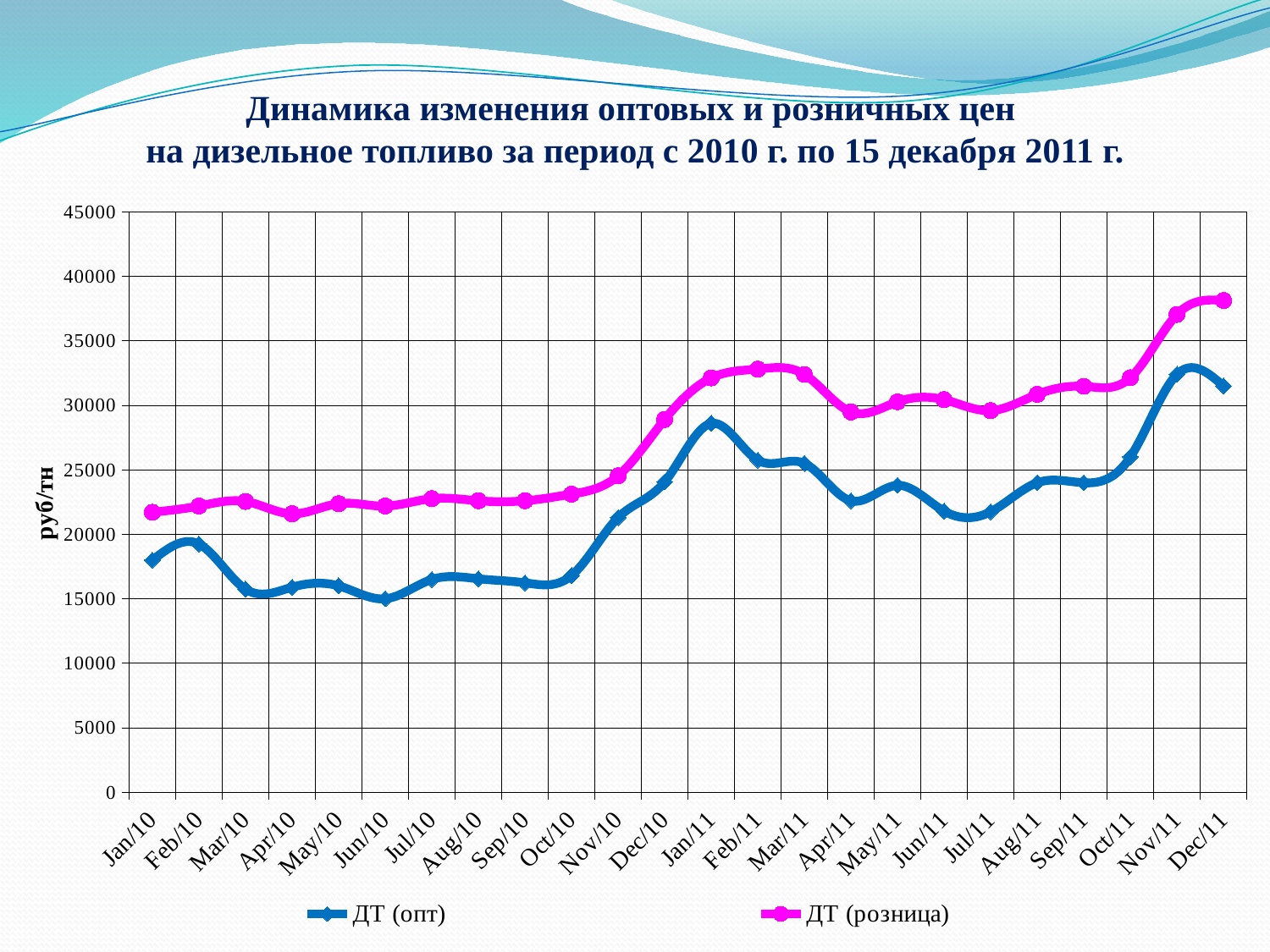
What kind of chart is shown on the slide? line chart In which month does the ДТ (розница) series reach its highest value? Dec/11 Is the value of ДТ (опт) in Jan/10 greater or less than 20000? less Is the value of ДТ (опт) in Jan/11 greater or less than 25000? greater Is the value of ДТ (розница) in Dec/11 greater or less than 35000? greater How many series does the legend list? 2 Which series has the higher value in Dec/11, ДТ (опт) or ДТ (розница)? ДТ (розница) Does the ДТ (розница) series overall rise or fall from Jan/10 to Dec/11? rise How many months (data points) are plotted along the x axis? 24 In which month does the ДТ (опт) series reach its highest value? Nov/11 What is the label on the vertical axis? руб/тн